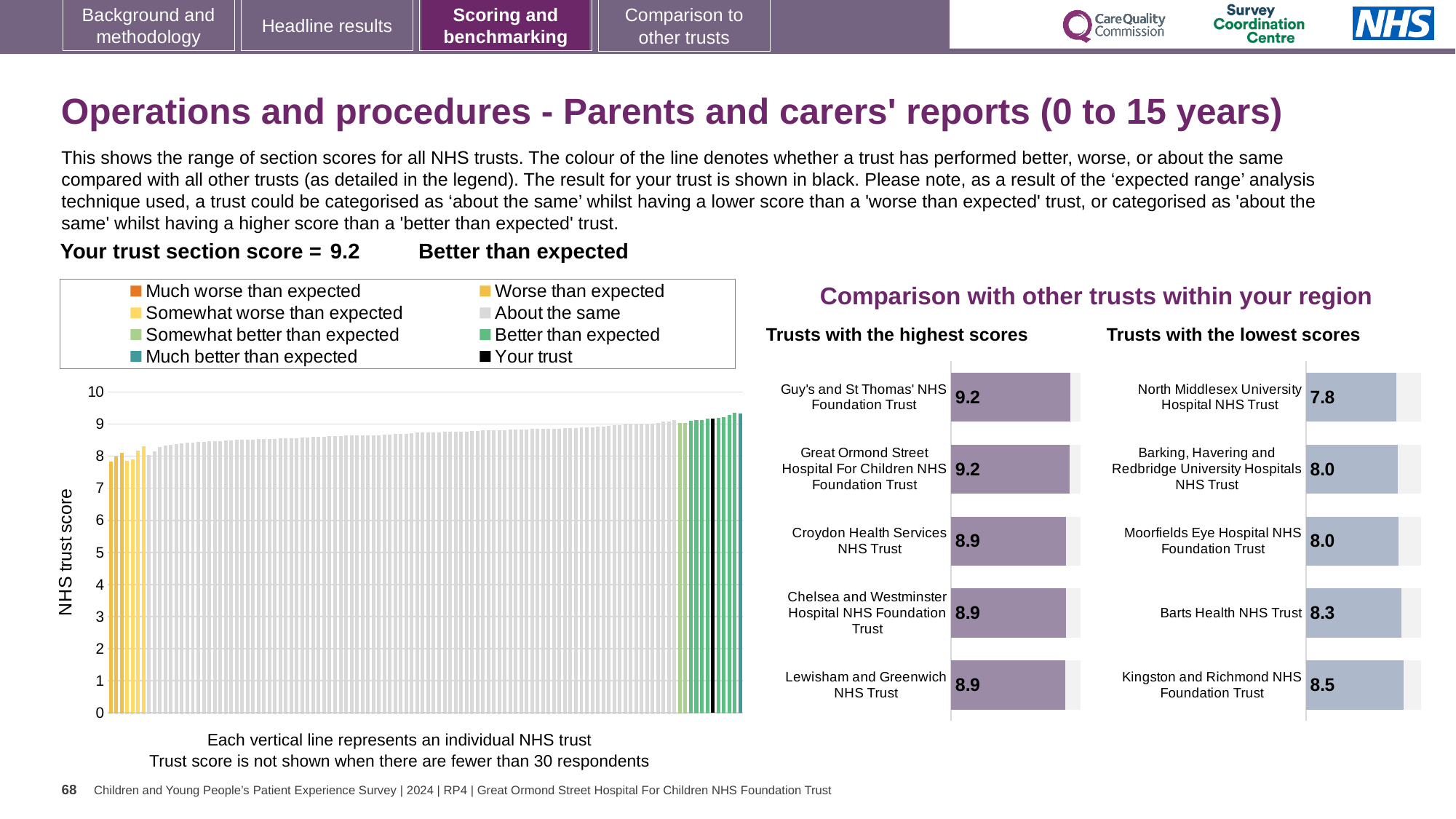
In the 'Trusts with the lowest scores' chart, which is larger: the score for Barts Health NHS Trust or the score for Moorfields Eye Hospital NHS Foundation Trust? Barts Health NHS Trust In the 'Trusts with the highest scores' chart, what is the difference between the score for Guy's and St Thomas' NHS Foundation Trust and the score for Lewisham and Greenwich NHS Trust? 0.3 In the 'Trusts with the lowest scores' chart, which trust has the highest score? Kingston and Richmond NHS Foundation Trust In the 'Trusts with the lowest scores' chart, what is the difference between the score for Kingston and Richmond NHS Foundation Trust and the score for North Middlesex University Hospital NHS Trust? 0.7 In the 'Trusts with the highest scores' chart, how many trusts are listed? 5 In the large 'NHS trust score' chart on the left, is the value of the black bar (your trust) greater or less than 9? greater In the 'Trusts with the highest scores' chart, what is the score for Croydon Health Services NHS Trust? 8.9 How many entries does the legend above the large 'NHS trust score' chart list? 8 In the 'Trusts with the lowest scores' chart, what is the score for North Middlesex University Hospital NHS Trust? 7.8 In the 'Trusts with the lowest scores' chart, which trust has the lowest score? North Middlesex University Hospital NHS Trust What kind of chart is the large 'NHS trust score' chart on the left of the slide? Bar chart In the large 'NHS trust score' chart on the left, do the values rise or fall from left to right? Rise